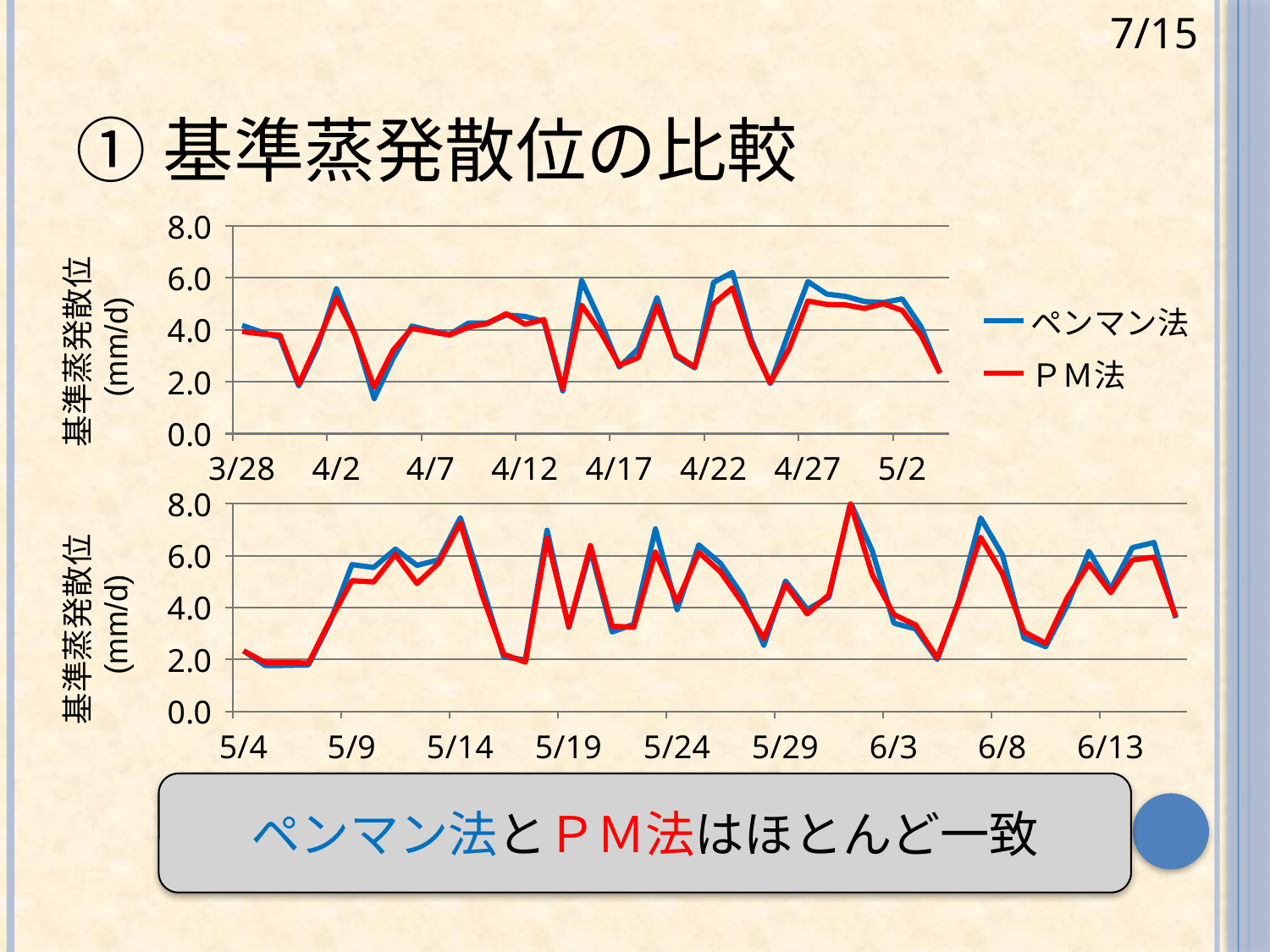
In the bottom chart (5/4 to 6/13), do the values rise or fall from 5/4 to 5/9? rise In the top chart (3/28 to 5/2), do the values rise or fall from 5/2 to the last point? fall In the bottom chart (5/4 to 6/13), is the ペンマン法 value at 5/29 greater or less than 4.0? greater In the bottom chart (5/4 to 6/13), is the ペンマン法 value at 5/14 greater or less than 6.0? greater In the top chart, which series is drawn in red? ＰＭ法 In the top chart (3/28 to 5/2), is the ペンマン法 value at the dip just after 4/2 greater or less than 2.0? less How many series does the legend of the top chart list? 2 What unit is shown on the y-axis label of the charts? mm/d What kind of chart is the top chart on the slide? line chart In the top chart (3/28 to 5/2), at the peak near 4/22, which series is higher, ペンマン法 or ＰＭ法? ペンマン法 How many charts are shown on the slide? 2